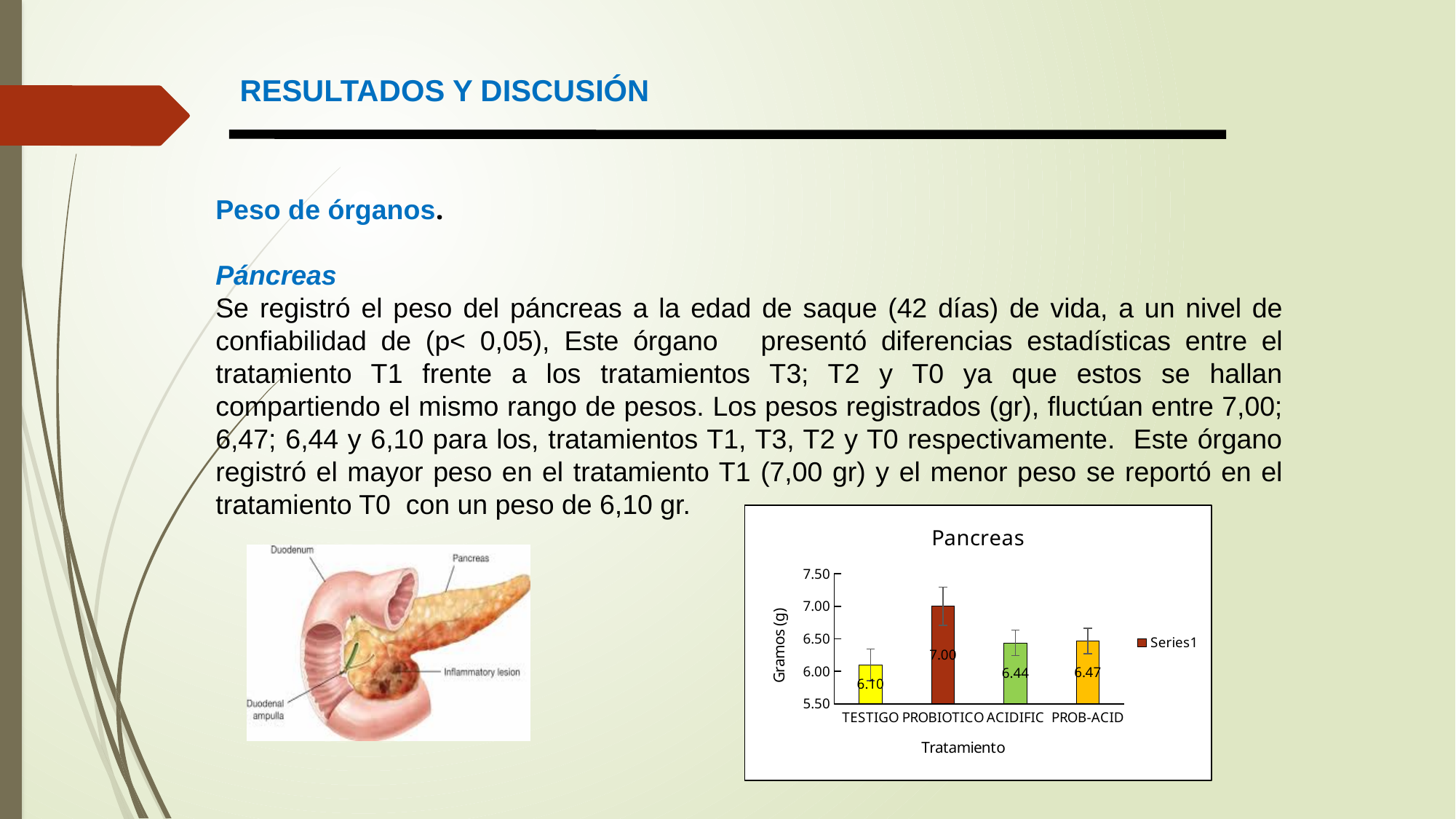
What is the value for ACIDIFIC in the Pancreas chart? 6.44 What is the value for PROB-ACID in the Pancreas chart? 6.47 Which treatment has the highest value in the Pancreas chart? PROBIOTICO What is the label of the y axis in the Pancreas chart? Gramos (g) Which is larger in the Pancreas chart, the value for PROBIOTICO or the value for ACIDIFIC? PROBIOTICO How many treatment categories are shown in the Pancreas chart? 4 Is the value for TESTIGO in the Pancreas chart greater or less than 6.50? less What type of chart is the Pancreas chart? bar chart What is the value for TESTIGO in the Pancreas chart? 6.10 What is the value for PROBIOTICO in the Pancreas chart? 7.00 What is the difference between the PROBIOTICO and TESTIGO values in the Pancreas chart? 0.90 Which treatment has the lowest value in the Pancreas chart? TESTIGO